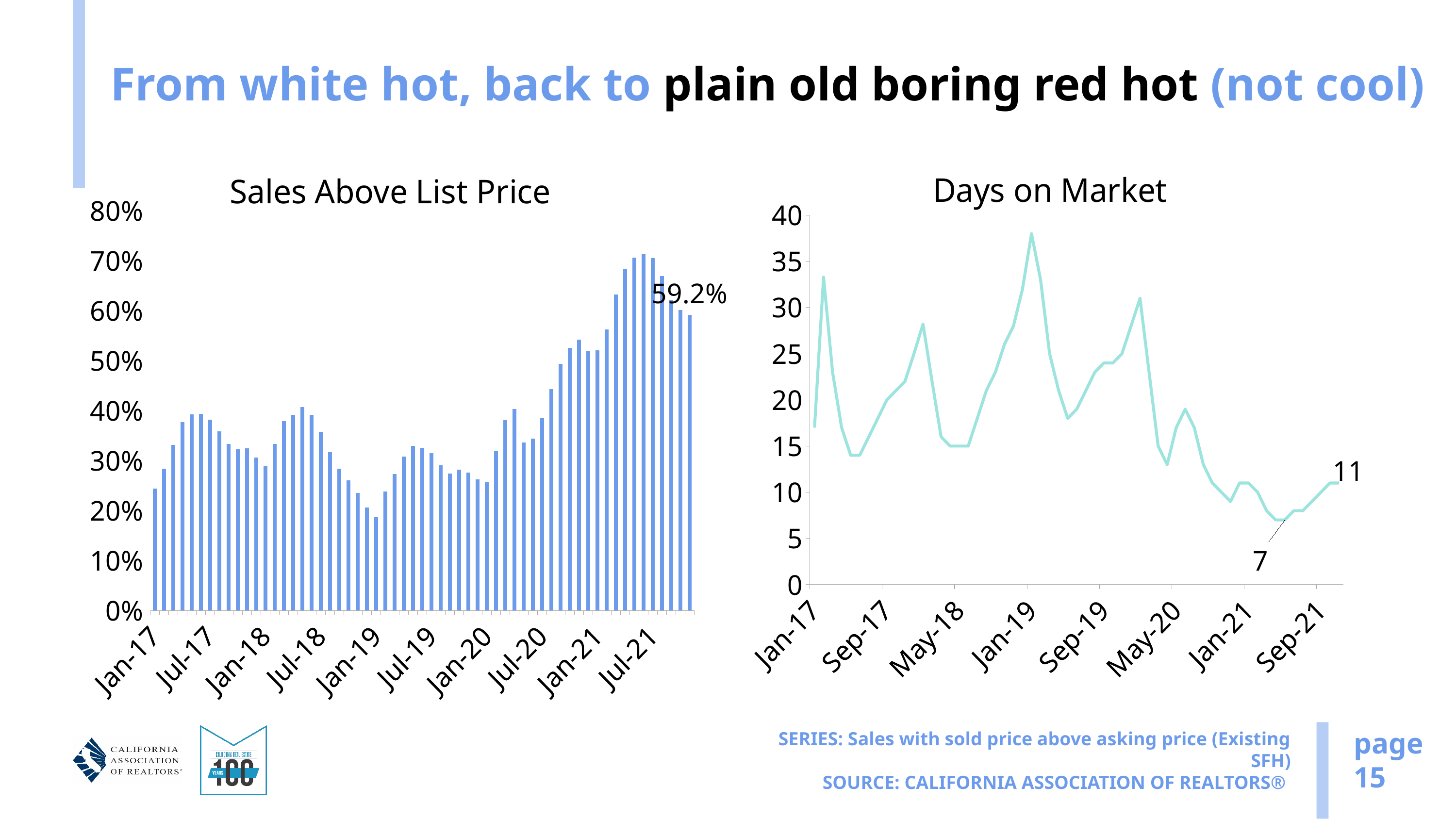
What kind of chart is the 'Days on Market' chart on the right? line chart What is the title of the chart on the right side of the slide? Days on Market In the 'Sales Above List Price' chart, is the final bar (59.2%) higher or lower than the Jan-17 bar? higher In the 'Days on Market' chart, is the peak value near Jan-19 greater or less than 35? greater In the 'Sales Above List Price' chart, is the value for Jan-17 greater or less than 30%? less In the 'Days on Market' chart, what value is labelled at the end of the line? 11 In the 'Days on Market' chart, what is the difference between the final labelled value and the labelled low of 7? 4 In the 'Sales Above List Price' chart, what value is labelled on the final bar? 59.2% In the 'Sales Above List Price' chart, do the values rise or fall between Jan-21 and Jul-21? rise In the 'Days on Market' chart, what is the lowest labelled value on the line? 7 What kind of chart is the 'Sales Above List Price' chart on the left? bar chart In the 'Days on Market' chart, is the value for Jan-17 greater or less than 20? less